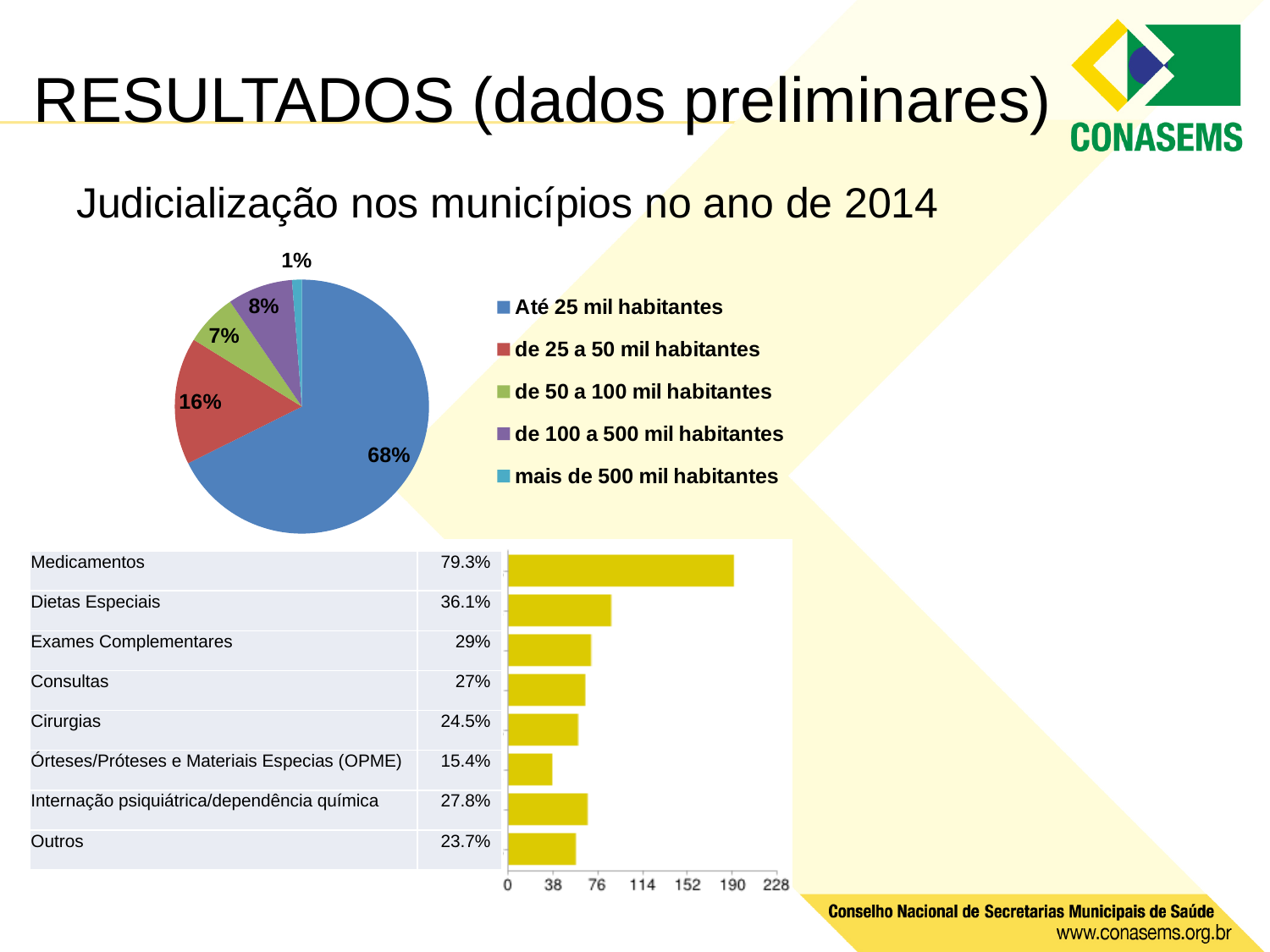
In the pie chart 'Judicialização nos municípios no ano de 2014', what share is shown for 'Até 25 mil habitantes'? 68% In the pie chart 'Judicialização nos municípios no ano de 2014', which category has the largest slice? Até 25 mil habitantes In the pie chart 'Judicialização nos municípios no ano de 2014', what is the difference between the shares for 'de 25 a 50 mil habitantes' and 'de 50 a 100 mil habitantes'? 9% In the bar chart at the bottom of the slide, what percentage is shown for 'Medicamentos'? 79.3% In the pie chart 'Judicialização nos municípios no ano de 2014', what share is shown for 'de 100 a 500 mil habitantes'? 8% In the bar chart at the bottom of the slide, is the bar for 'Medicamentos' greater or less than 152 on the axis? greater In the pie chart 'Judicialização nos municípios no ano de 2014', what share is shown for 'de 25 a 50 mil habitantes'? 16% In the pie chart 'Judicialização nos municípios no ano de 2014', which category has the smallest slice? mais de 500 mil habitantes In the bar chart at the bottom of the slide, which category has the lowest percentage? Órteses/Próteses e Materiais Especias (OPME) In the pie chart 'Judicialização nos municípios no ano de 2014', how many categories does the legend list? 5 In the bar chart at the bottom of the slide, what percentage is shown for 'Internação psiquiátrica/dependência química'? 27.8% What kind of chart is shown at the bottom of the slide? bar chart